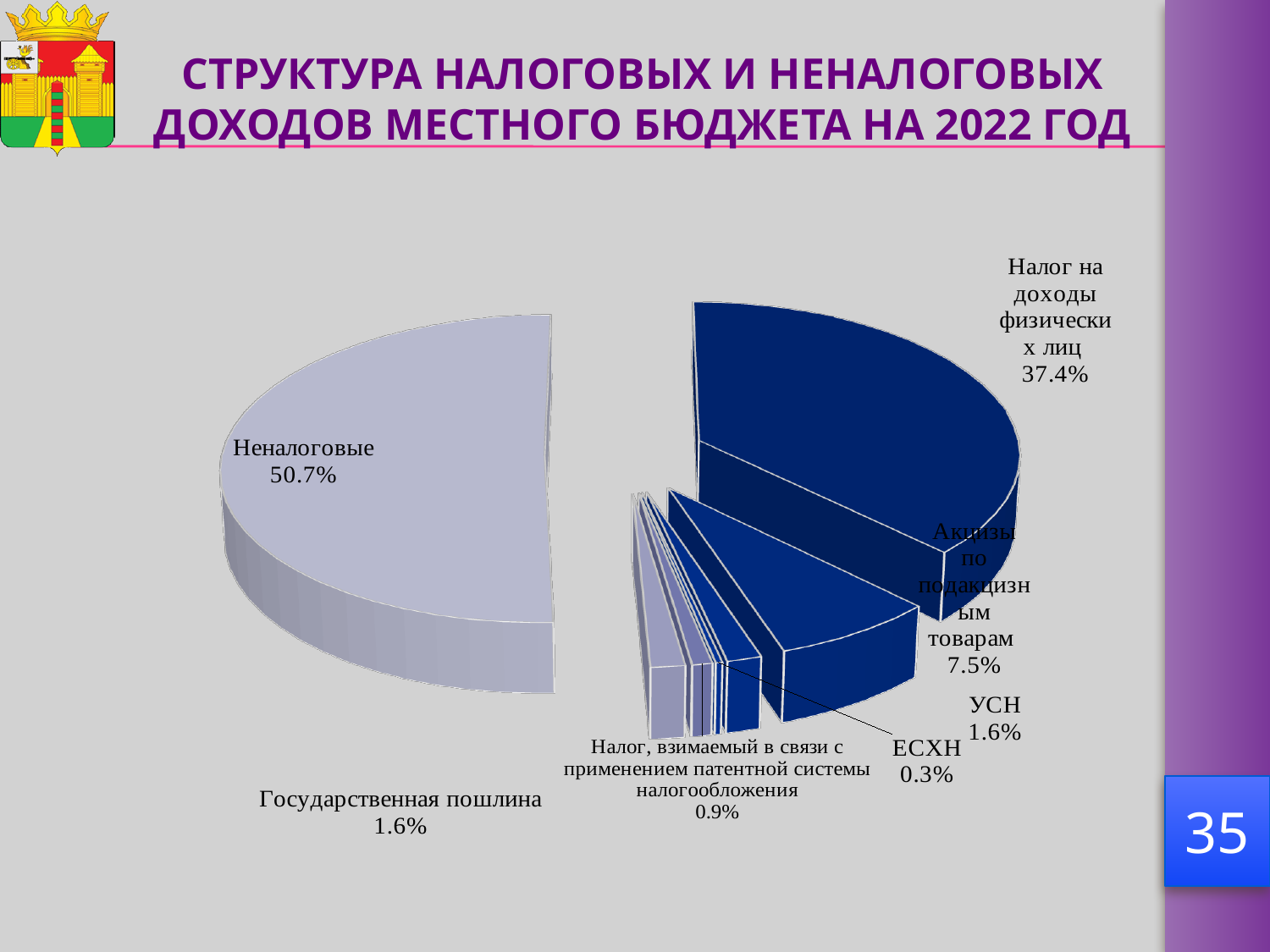
What is the value labelled for ЕСХН? 0.3% What share of the pie does Неналоговые hold? 50.7% What share is shown for Налог, взимаемый в связи с применением патентной системы налогообложения? 0.9% What is the value shown for Налог на доходы физических лиц? 37.4% Which category has the largest slice of the pie? Неналоговые What type of chart is shown on the slide? Pie chart What is the title of the slide containing the chart? СТРУКТУРА НАЛОГОВЫХ И НЕНАЛОГОВЫХ ДОХОДОВ МЕСТНОГО БЮДЖЕТА НА 2022 ГОД Which category has the smallest slice of the pie? ЕСХН How many slices does the pie chart have? 7 What is the difference between the shares of Неналоговые and Налог на доходы физических лиц? 13.3% Which is larger: the share for Акцизы по подакцизным товарам or the share for УСН? Акцизы по подакцизным товарам What percentage is shown for Акцизы по подакцизным товарам? 7.5%